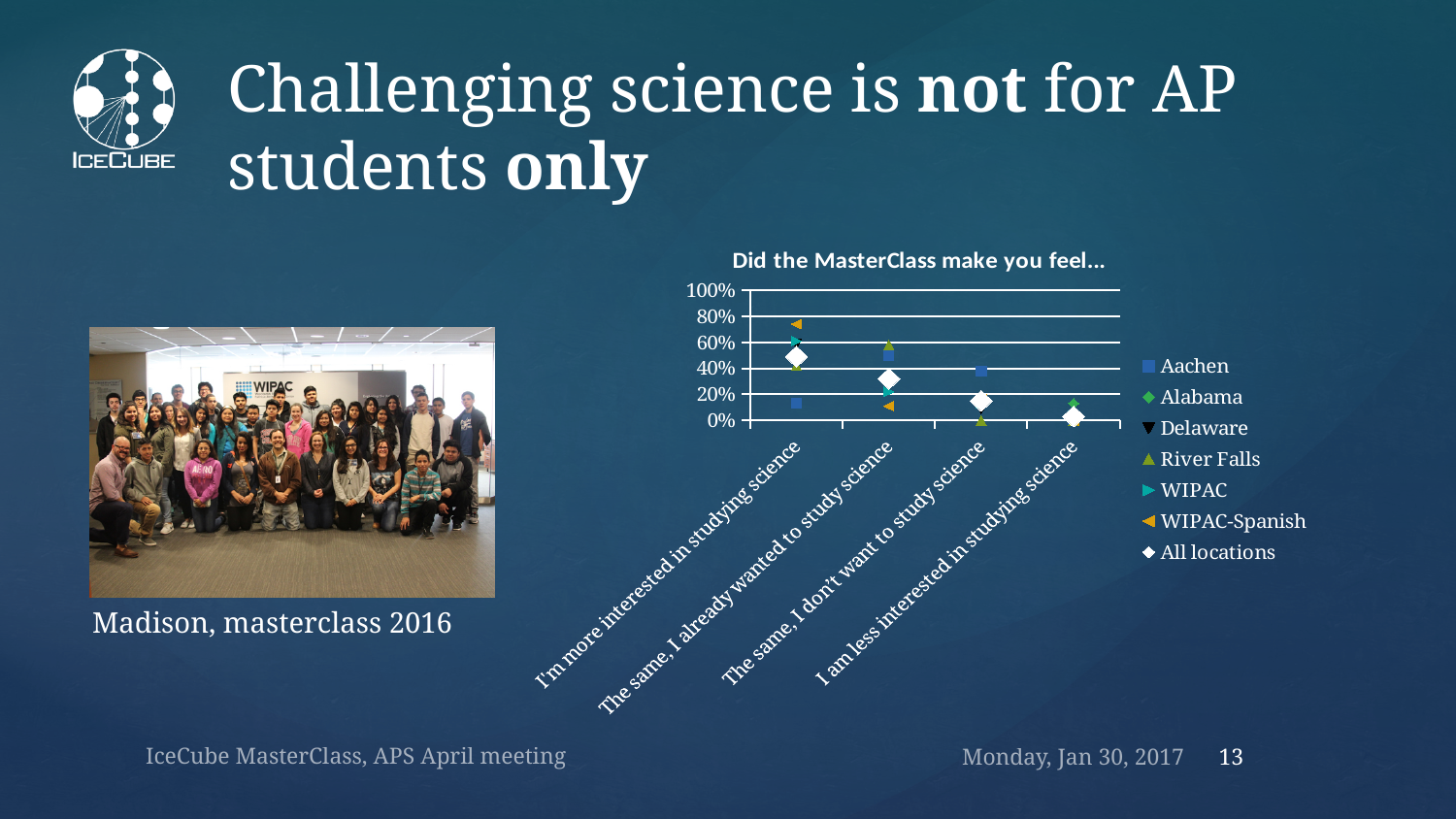
Do the values for the All locations series rise or fall from left to right along the x axis? fall Which location has the highest value for "I'm more interested in studying science"? WIPAC-Spanish How many series does the chart legend list? 7 How many response categories are shown along the x axis of the chart? 4 What is the title of the chart? Did the MasterClass make you feel... Is the All locations value for "I'm more interested in studying science" greater or less than 40%? greater Is the All locations value for "I am less interested in studying science" greater or less than 20%? less Is the Aachen value for "I'm more interested in studying science" greater or less than 20%? less Which series in the legend is shown with a white diamond marker? All locations For "I'm more interested in studying science", which is larger: the WIPAC-Spanish value or the Aachen value? WIPAC-Spanish What kind of chart is shown on the slide? scatter chart